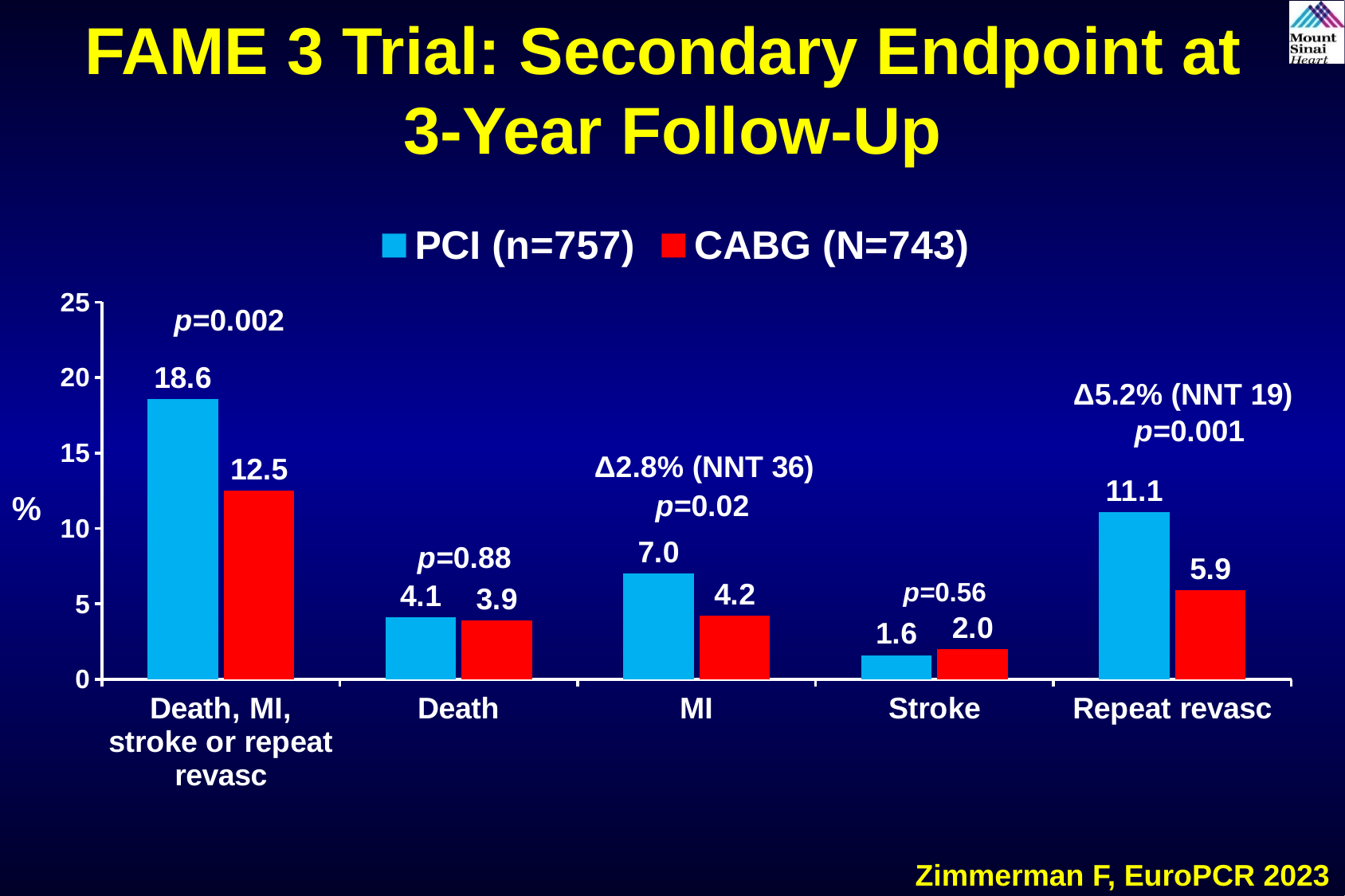
How many series does the legend list? 2 What is the CABG value for stroke? 2.0 What is the CABG value for repeat revasc? 5.9 Which category has the highest PCI value? Death, MI, stroke or repeat revasc Which category has the lowest CABG value? Stroke What is the difference between the PCI and CABG values for MI? 2.8 What p-value is shown for the death category? p=0.88 How many categories are shown on the x axis? 5 What kind of chart is shown on the slide? Bar chart What is the difference between the PCI and CABG values for the composite endpoint of death, MI, stroke or repeat revasc? 6.1 Which is larger for stroke, the PCI value or the CABG value? CABG What is the PCI value for the composite endpoint of death, MI, stroke or repeat revasc? 18.6